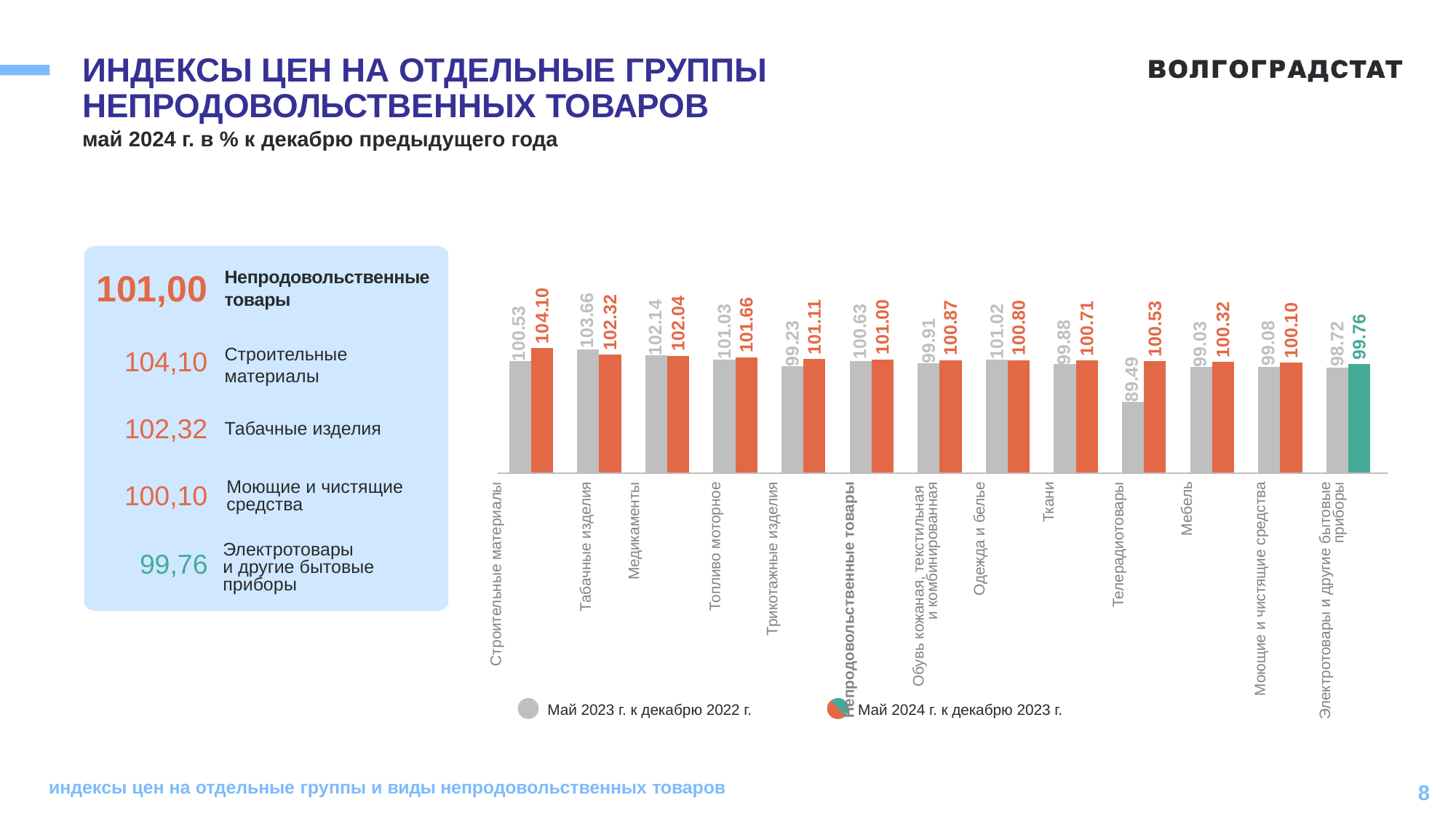
What is the value for Телерадиотовары in the series Май 2023 г. к декабрю 2022 г.? 89.49 Which category has the lowest value in the series Май 2024 г. к декабрю 2023 г.? Электротовары и другие бытовые приборы What is the value for Непродовольственные товары in the series Май 2023 г. к декабрю 2022 г.? 100.63 What is the difference between the two series values for Строительные материалы? 3.57 How many series does the chart legend list? 2 How many categories are shown on the x axis of the chart? 13 What is the value for Электротовары и другие бытовые приборы in the series Май 2024 г. к декабрю 2023 г.? 99.76 Which category has the highest value in the series Май 2024 г. к декабрю 2023 г.? Строительные материалы For Табачные изделия, which series has the larger value: Май 2023 г. к декабрю 2022 г. or Май 2024 г. к декабрю 2023 г.? Май 2023 г. к декабрю 2022 г. Which category has the lowest value in the series Май 2023 г. к декабрю 2022 г.? Телерадиотовары What is the value for Строительные материалы in the series Май 2024 г. к декабрю 2023 г.? 104.10 What is the difference between the two series values for Телерадиотовары? 11.04